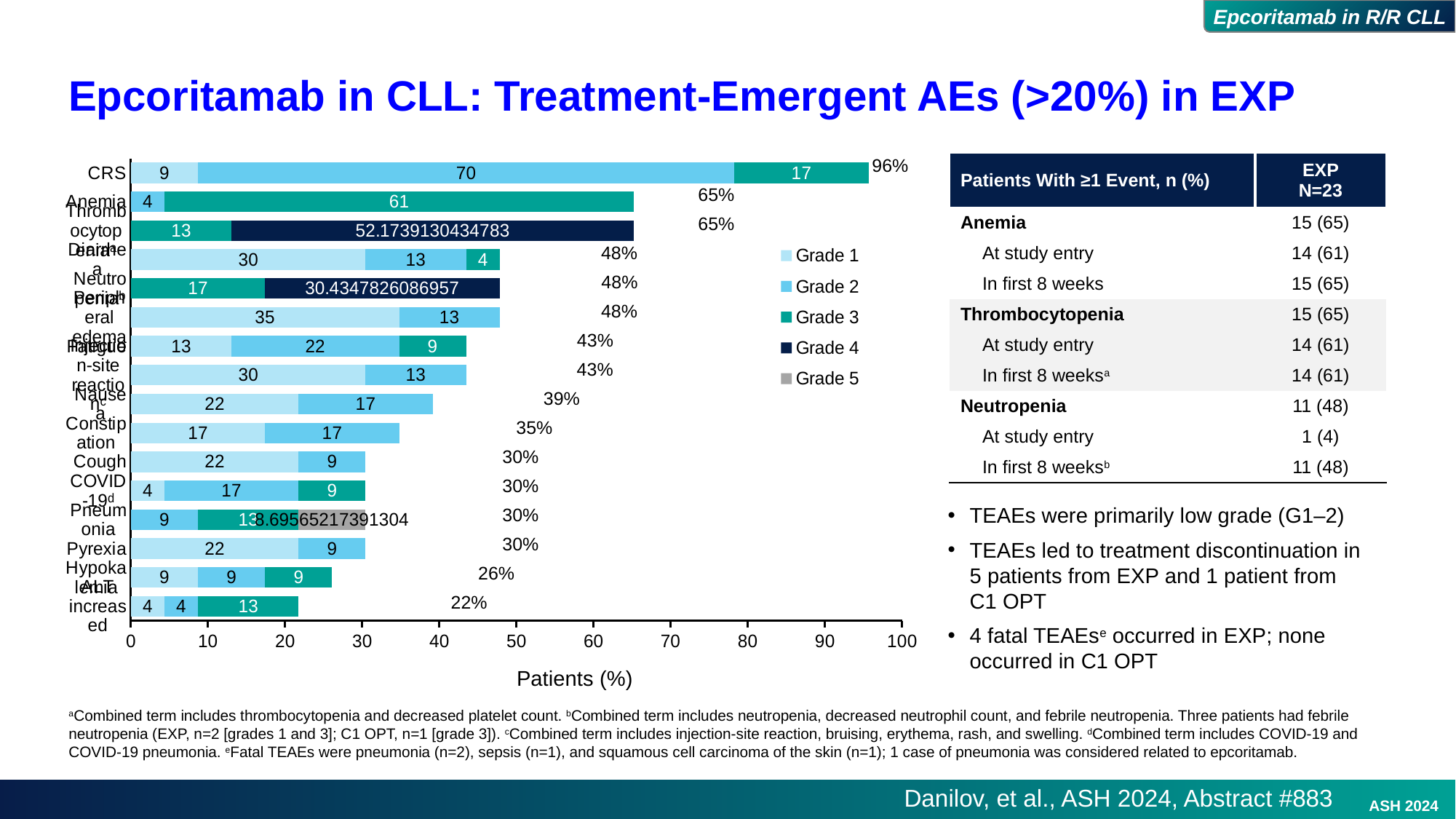
What is the difference between the total percentage for CRS and the total percentage for Anemia? 31 percentage points How many grade series does the legend list? 5 Which has a larger Grade 1 value, Diarrhea or Nausea? Diarrhea What is the Grade 2 value for CRS? 70 How many adverse event categories are plotted on the chart? 16 What is the Grade 3 value for Fatigue? 9 What kind of chart is shown on the slide? Stacked bar chart Which adverse event has the highest total percentage of patients? CRS What is the title of the x axis? Patients (%) What total percentage is labelled at the end of the CRS bar? 96% Which adverse event has the lowest total percentage of patients? ALT increased What is the Grade 3 value for Anemia? 61